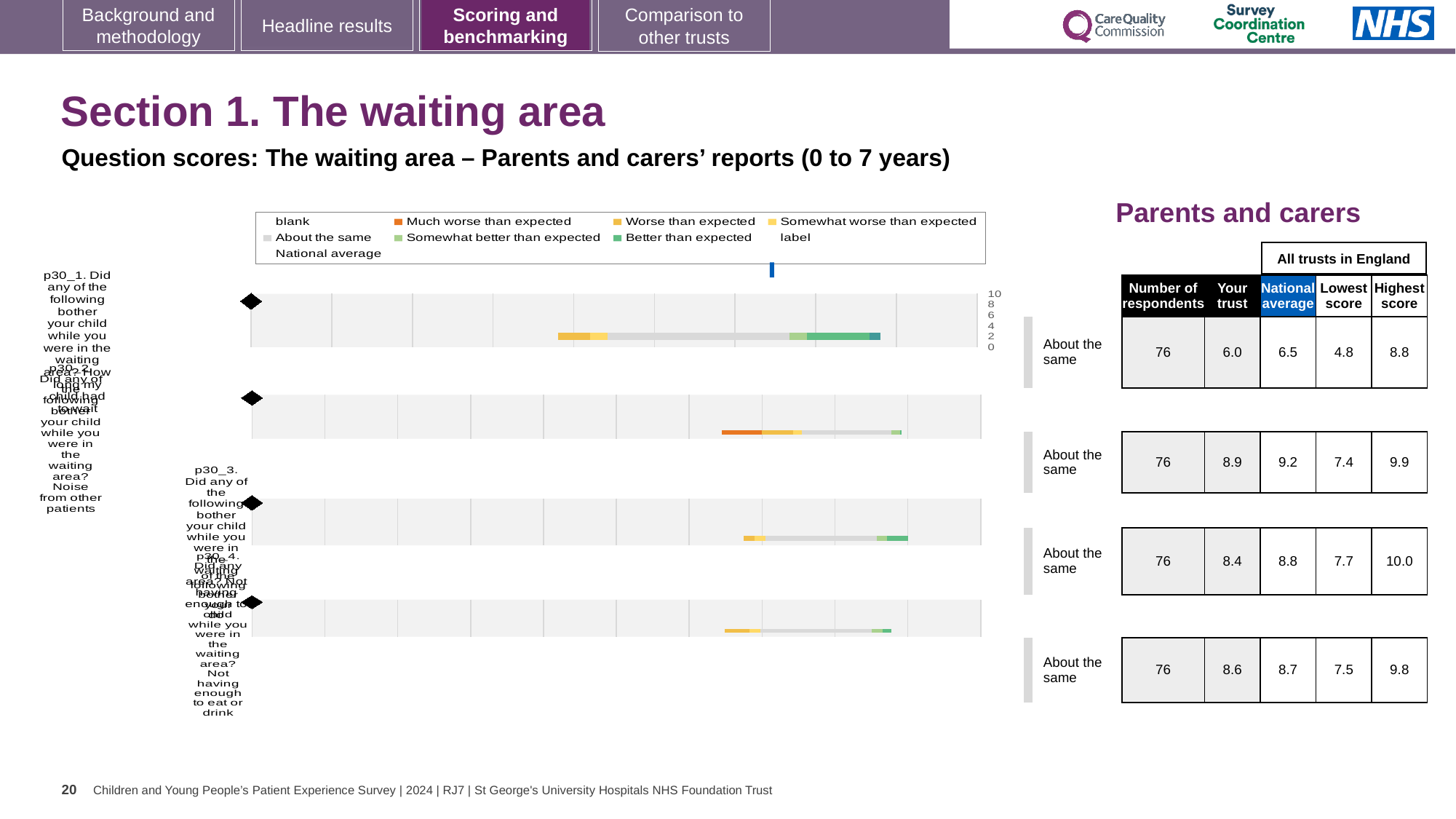
Which of the four waiting area questions has the lowest 'Your trust' score in the table? p30_1 (How long my child had to wait) What kind of chart is used to show the question scores for the waiting area? bar chart In the table beside the chart, how many respondents answered p30_4 (Not having enough to eat or drink)? 76 In the table beside the chart, what is the highest score for p30_3 (Not having enough to do)? 10.0 How many questions (bars) are plotted in the waiting area chart? 4 In the legend of the waiting area chart, what colour represents 'National average'? blue Which of the four waiting area questions has the highest 'Your trust' score in the table? p30_2 (Noise from other patients) In the legend of the waiting area chart, what colour represents 'Much worse than expected'? orange How many entries does the legend of the waiting area chart list? 9